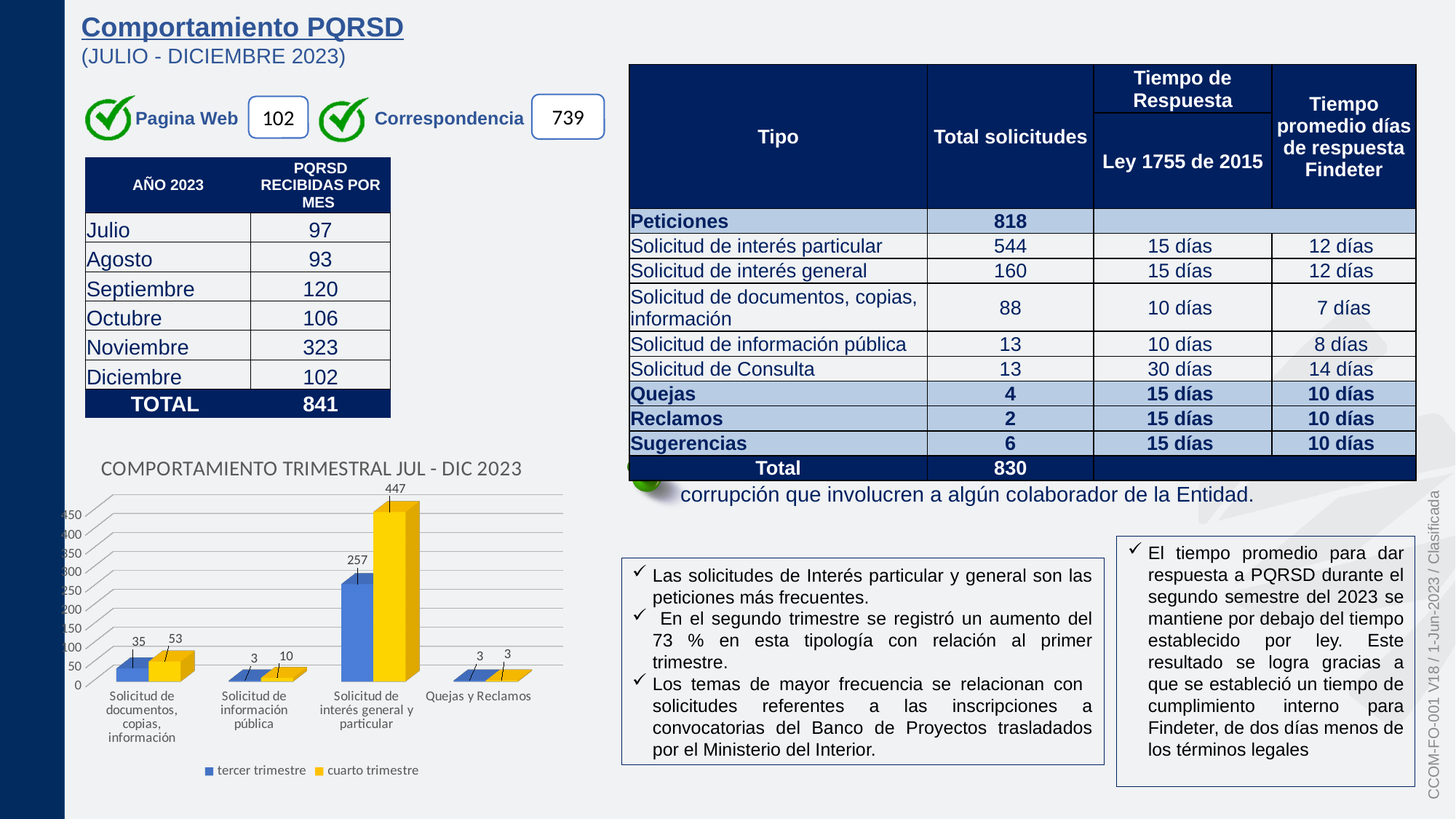
In the chart 'COMPORTAMIENTO TRIMESTRAL JUL - DIC 2023', what is the value for 'tercer trimestre' in the category 'Solicitud de documentos, copias, información'? 35 In the chart 'COMPORTAMIENTO TRIMESTRAL JUL - DIC 2023', what is the difference between the 'cuarto trimestre' and 'tercer trimestre' values for 'Solicitud de documentos, copias, información'? 18 What kind of chart is 'COMPORTAMIENTO TRIMESTRAL JUL - DIC 2023'? bar chart In the chart 'COMPORTAMIENTO TRIMESTRAL JUL - DIC 2023', which category has the lowest value for 'cuarto trimestre'? Quejas y Reclamos In the chart 'COMPORTAMIENTO TRIMESTRAL JUL - DIC 2023', is the 'tercer trimestre' value for 'Solicitud de interés general y particular' greater or less than 200? greater In the chart 'COMPORTAMIENTO TRIMESTRAL JUL - DIC 2023', what is the value for 'cuarto trimestre' in the category 'Solicitud de interés general y particular'? 447 How many categories are shown on the x axis of the chart 'COMPORTAMIENTO TRIMESTRAL JUL - DIC 2023'? 4 How many series does the legend of the chart 'COMPORTAMIENTO TRIMESTRAL JUL - DIC 2023' list? 2 In the chart 'COMPORTAMIENTO TRIMESTRAL JUL - DIC 2023', what is the difference between the 'cuarto trimestre' and 'tercer trimestre' values for 'Solicitud de interés general y particular'? 190 In the chart 'COMPORTAMIENTO TRIMESTRAL JUL - DIC 2023', which category has the highest value for 'tercer trimestre'? Solicitud de interés general y particular In the chart 'COMPORTAMIENTO TRIMESTRAL JUL - DIC 2023', which is larger for 'Solicitud de información pública': 'tercer trimestre' or 'cuarto trimestre'? cuarto trimestre In the chart 'COMPORTAMIENTO TRIMESTRAL JUL - DIC 2023', what is the value for 'cuarto trimestre' in the category 'Solicitud de información pública'? 10